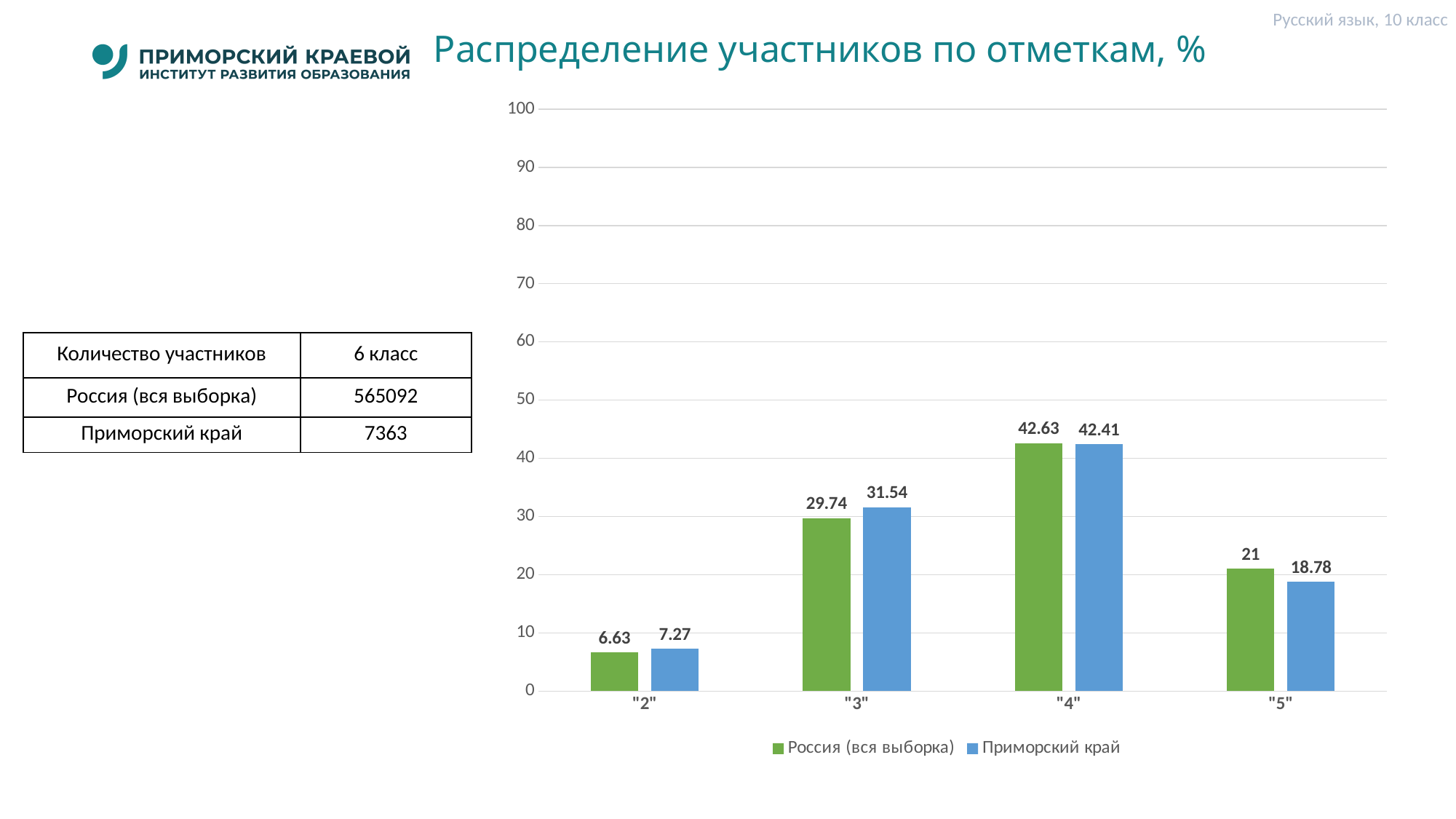
What kind of chart is shown on the slide? bar chart What is the value for Россия (вся выборка) at mark "3"? 29.74 At mark "5", which series has the larger value: Россия (вся выборка) or Приморский край? Россия (вся выборка) What is the value for Приморский край at mark "5"? 18.78 What is the value for Приморский край at mark "2"? 7.27 Which mark has the highest value for Приморский край? "4" How many series does the legend list? 2 What is the difference between Приморский край and Россия (вся выборка) at mark "3"? 1.8 How many mark categories are shown on the x axis? 4 What is the title of the chart? Распределение участников по отметкам, % Which mark has the lowest value for Россия (вся выборка)? "2" Is the value for Россия (вся выборка) at mark "4" greater or less than 40? greater